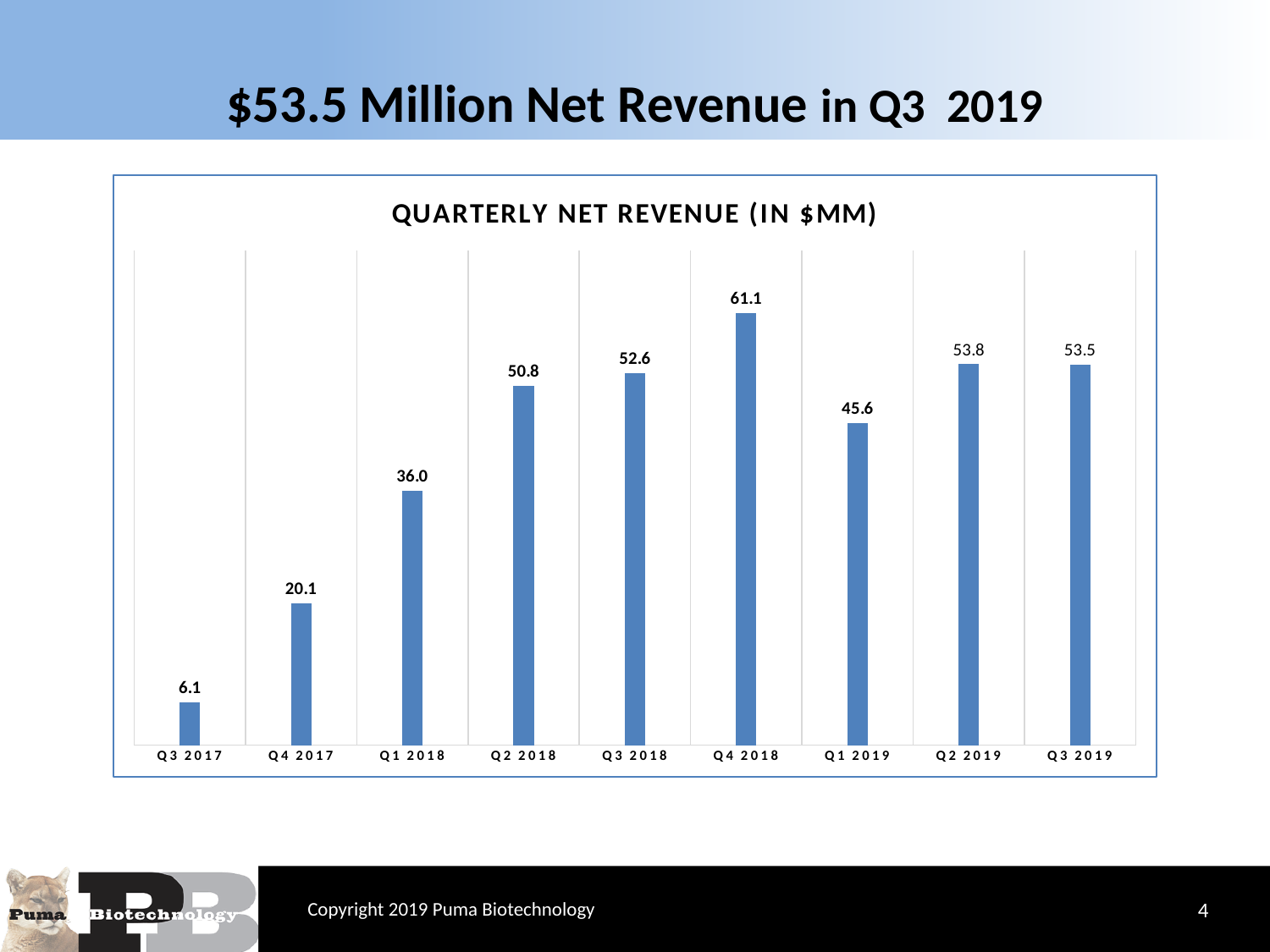
What is the difference in net revenue between Q4 2018 and Q1 2019? 15.5 What is the title of the chart? QUARTERLY NET REVENUE (IN $MM) What is the quarterly net revenue for Q4 2018? 61.1 What kind of chart is shown on the slide? Bar chart What is the difference in net revenue between Q1 2018 and Q4 2017? 15.9 Does net revenue rise or fall from Q3 2017 to Q4 2018? Rise Which quarter has the lowest net revenue? Q3 2017 Which quarter has the highest net revenue? Q4 2018 What is the quarterly net revenue for Q3 2017? 6.1 What is the quarterly net revenue for Q1 2019? 45.6 How many quarters are shown on the chart? 9 Which is larger, the net revenue for Q2 2018 or Q3 2018? Q3 2018